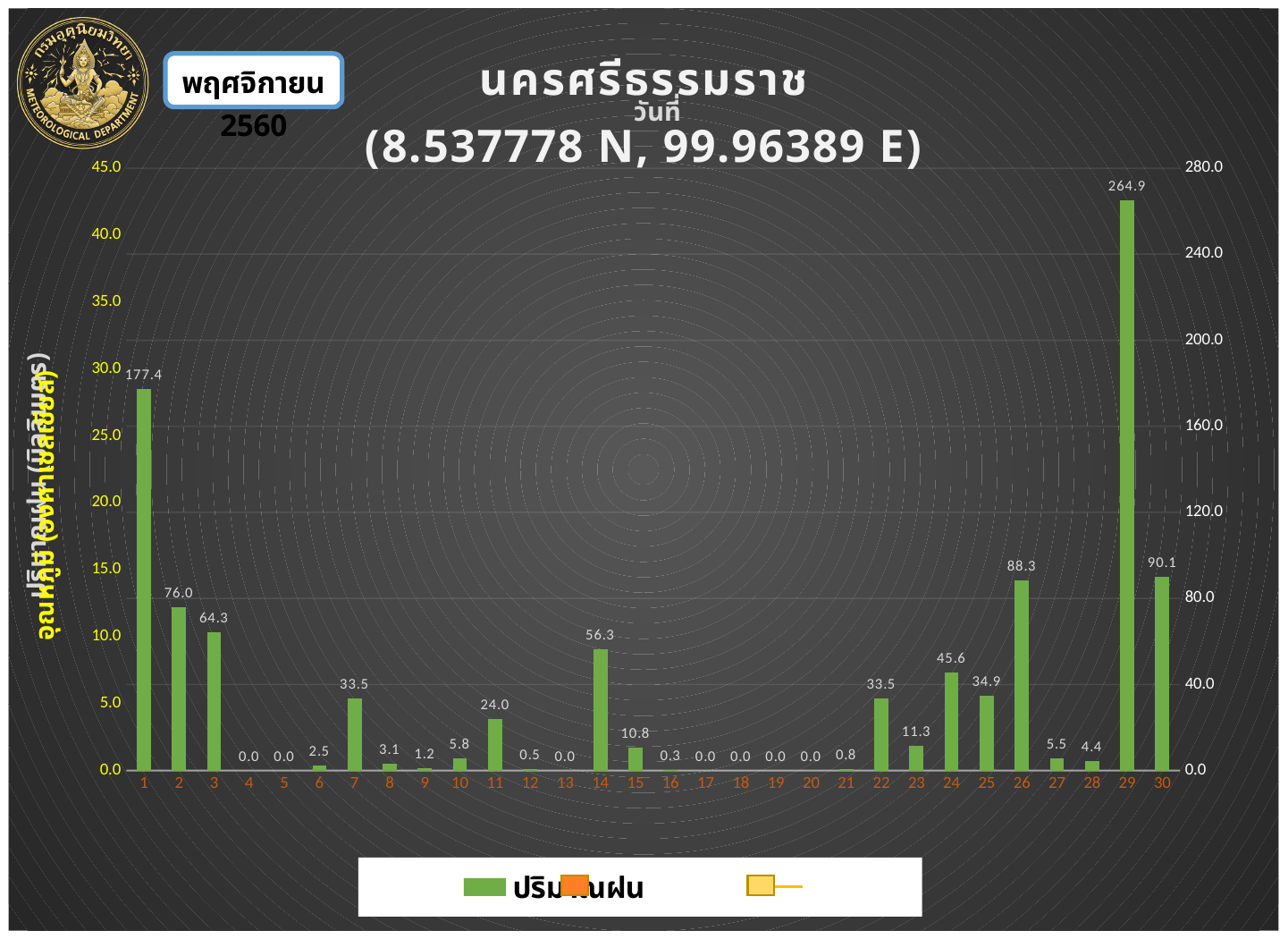
Which day has the highest rainfall value? 29 What coordinates are given in the chart title? 8.537778 N, 99.96389 E What kind of chart is shown on the slide? bar chart Which is larger, the rainfall value for day 24 or for day 25? day 24 What is the rainfall value shown for day 14? 56.3 What is the difference between the rainfall values for day 30 and day 26? 1.8 What is the rainfall value shown for day 26? 88.3 What is the rainfall value shown for day 29? 264.9 How many days are shown on the x axis? 30 What is the rainfall value shown for day 1? 177.4 What is the difference between the rainfall values for day 29 and day 1? 87.5 Which is larger, the rainfall value for day 2 or for day 3? day 2